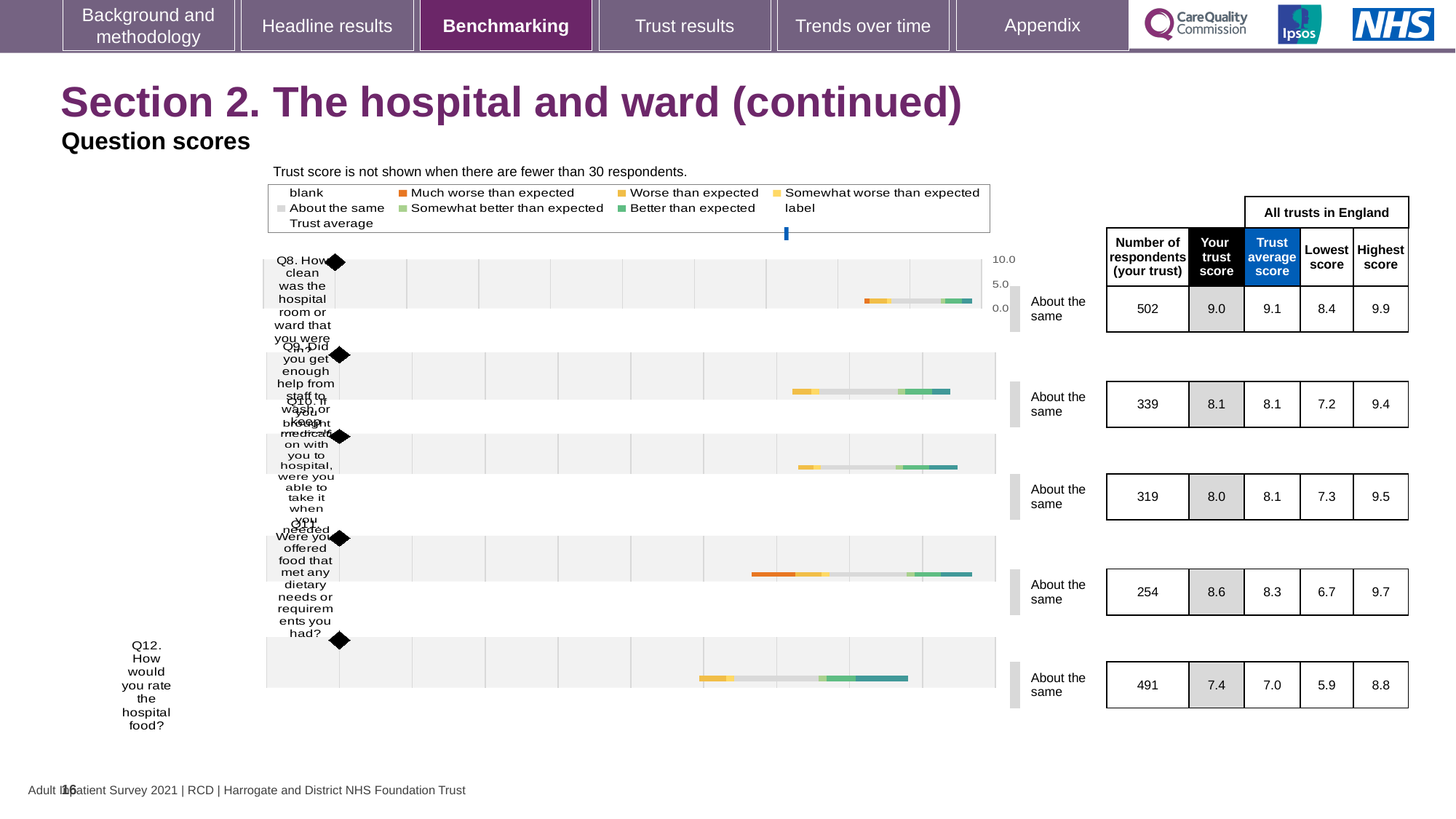
What is the difference between the 'Your trust score' and the 'Trust average score' for Q11? 0.3 Which question has the highest 'Your trust score'? Q8 Which question has the fewest respondents from your trust? Q11 How many respondents from your trust answered Q12 (How would you rate the hospital food)? 491 What kind of chart is used to show the question scores? Bar chart What is the 'Highest score' across all trusts in England for Q11? 9.7 How many questions are shown on the slide? 5 What is the 'Your trust score' for Q8 (How clean was the hospital room or ward)? 9.0 What is the 'Lowest score' across all trusts in England for Q12? 5.9 Which question has the lowest 'Your trust score'? Q12 What benchmark category is shown for Q9? About the same For Q12, which is larger: the 'Your trust score' or the 'Trust average score'? Your trust score